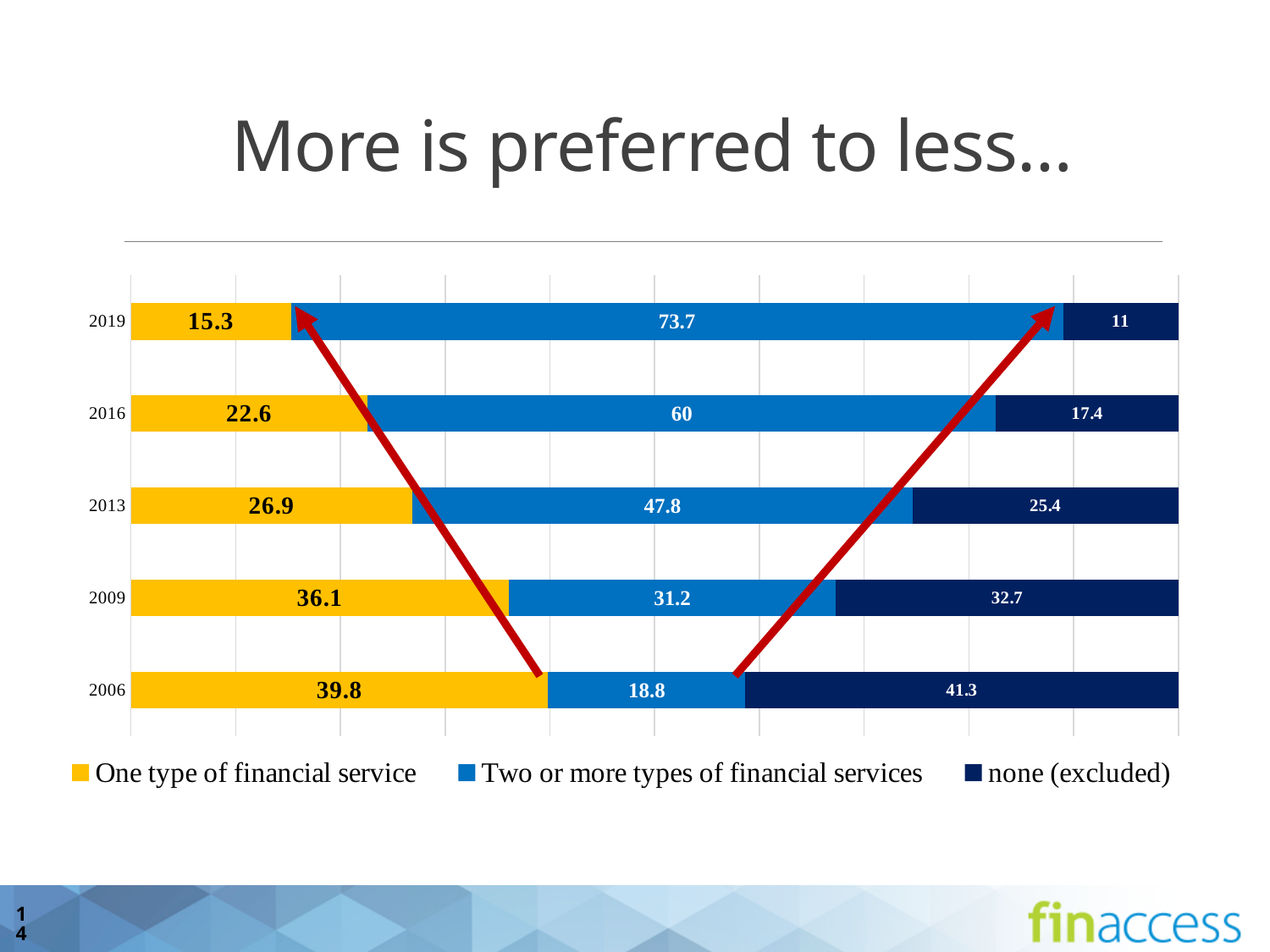
How many series does the legend list? 3 What kind of chart is shown on the slide? Stacked bar chart What is the value for 'One type of financial service' in 2006? 39.8 What is the value for 'none (excluded)' in 2013? 25.4 Which is larger in 2009: 'One type of financial service' or 'Two or more types of financial services'? One type of financial service What is the value for 'Two or more types of financial services' in 2019? 73.7 In which year is the value for 'none (excluded)' lowest? 2019 Does the value for 'One type of financial service' rise or fall from 2006 to 2019? Fall In which year is the value for 'Two or more types of financial services' highest? 2019 How many years are shown on the chart? 5 What is the difference between the 'Two or more types of financial services' values in 2019 and 2006? 54.9 What is the total of the stacked bar for 2016? 100